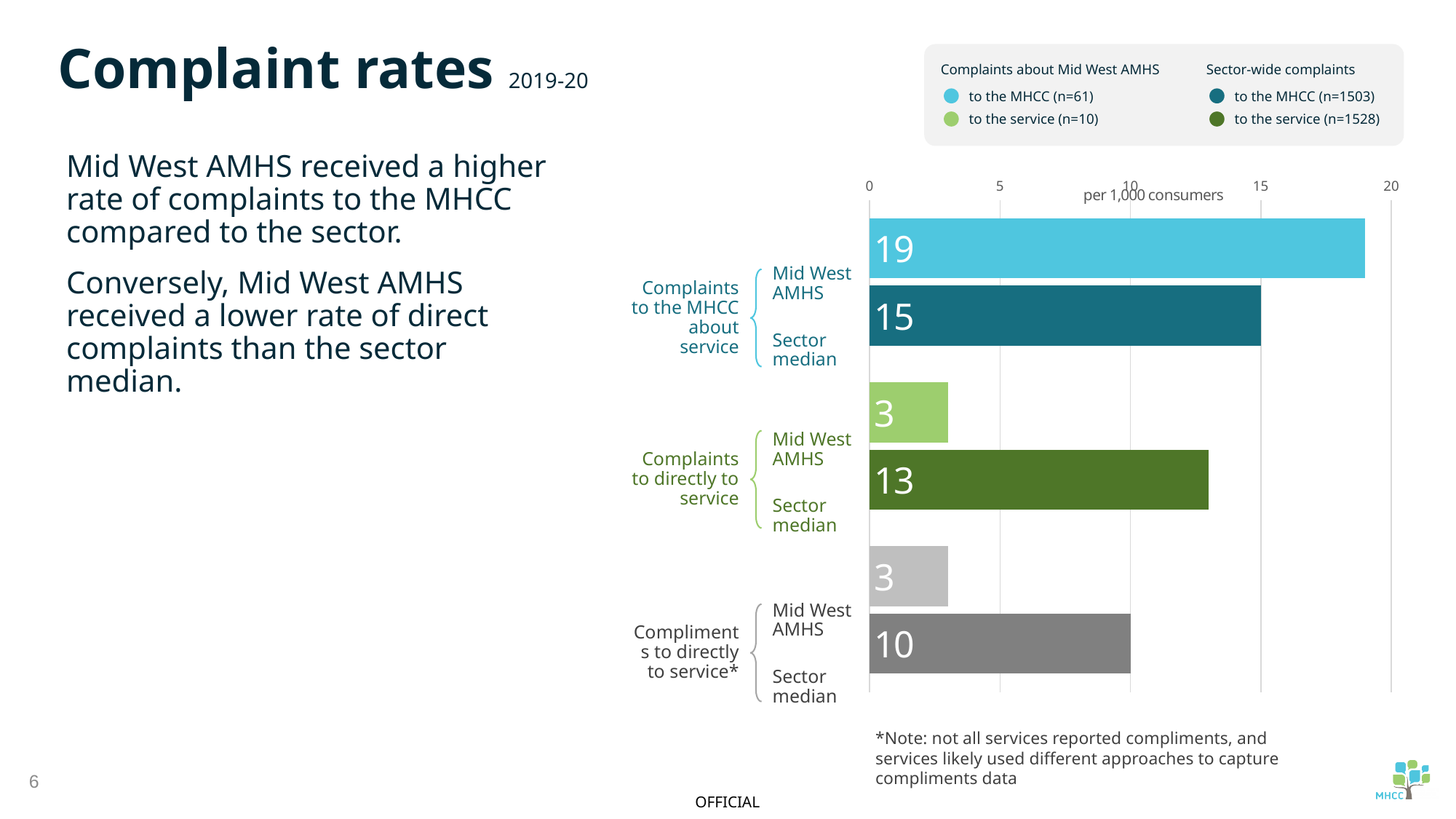
What is the rate of complaints to the MHCC about service for Mid West AMHS? 19 What is the sector median rate of compliments made directly to service? 10 How many entries does the legend list? 4 What is the difference between the Mid West AMHS rate and the sector median for complaints to the MHCC about service? 4 Which bar has the highest value on the chart? Mid West AMHS, complaints to the MHCC about service (19) What type of chart is shown on the slide? Bar chart What is the rate of complaints made directly to service for Mid West AMHS? 3 What unit is the horizontal axis of the chart measured in? per 1,000 consumers What is the sector median rate of complaints to the MHCC about service? 15 For complaints made directly to service, which is larger: Mid West AMHS or the sector median? Sector median How many bars are plotted on the chart? 6 What is the difference between the sector median and Mid West AMHS for complaints made directly to service? 10